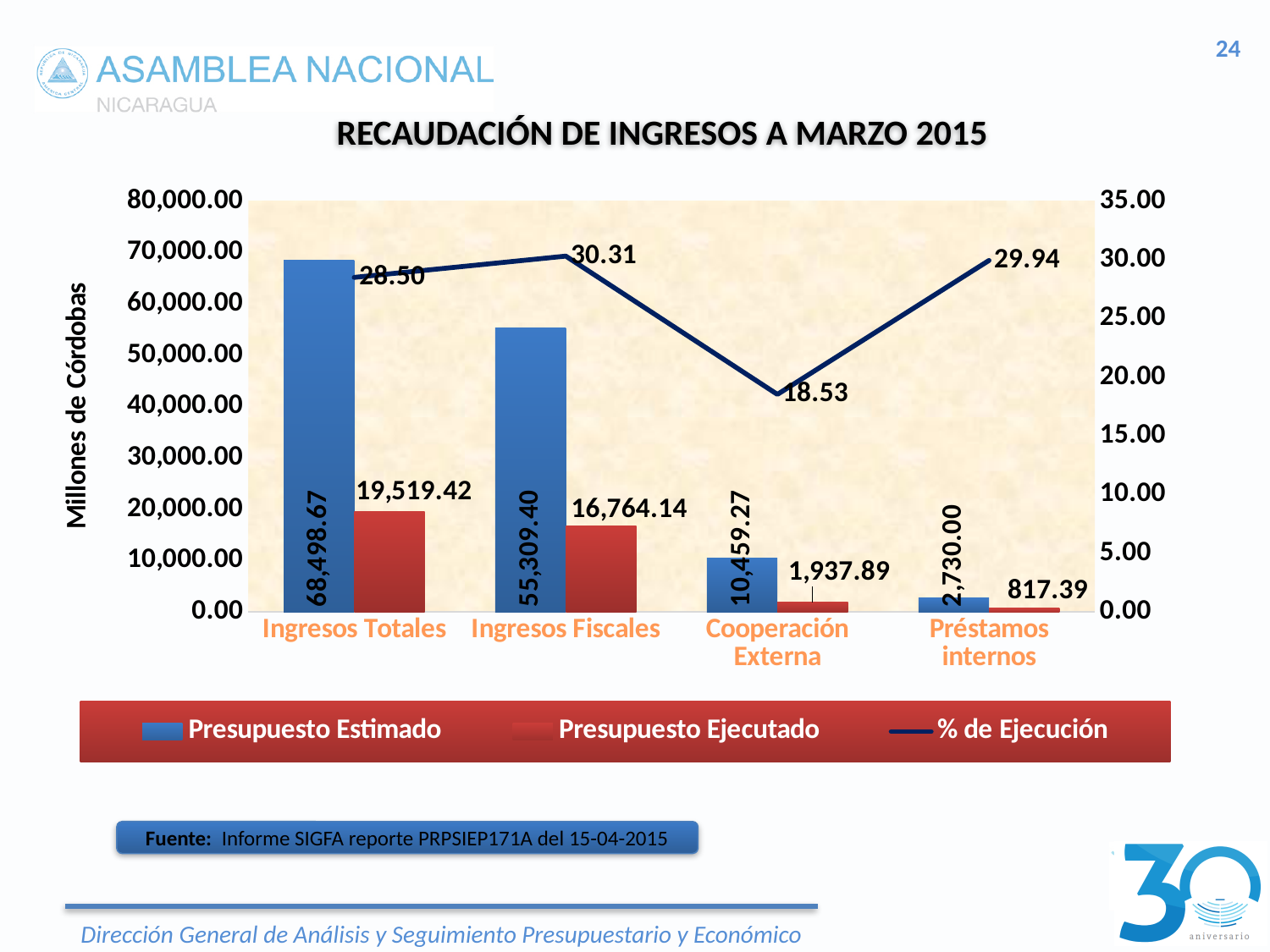
How many categories are shown on the x axis? 4 Which is larger: the Presupuesto Ejecutado for Ingresos Totales or for Ingresos Fiscales? Ingresos Totales What is the title of the chart? RECAUDACIÓN DE INGRESOS A MARZO 2015 Which category has the lowest Presupuesto Estimado? Préstamos internos What is the Presupuesto Ejecutado value for Préstamos internos? 817.39 How many series does the legend list? 3 What is the % de Ejecución for Cooperación Externa? 18.53 What is the difference between the % de Ejecución for Ingresos Fiscales and for Cooperación Externa? 11.78 What is the Presupuesto Estimado value for Ingresos Totales? 68,498.67 What is the Presupuesto Ejecutado value for Ingresos Fiscales? 16,764.14 What is the difference between the Presupuesto Estimado and the Presupuesto Ejecutado for Ingresos Totales? 48,979.25 Which category has the highest % de Ejecución? Ingresos Fiscales